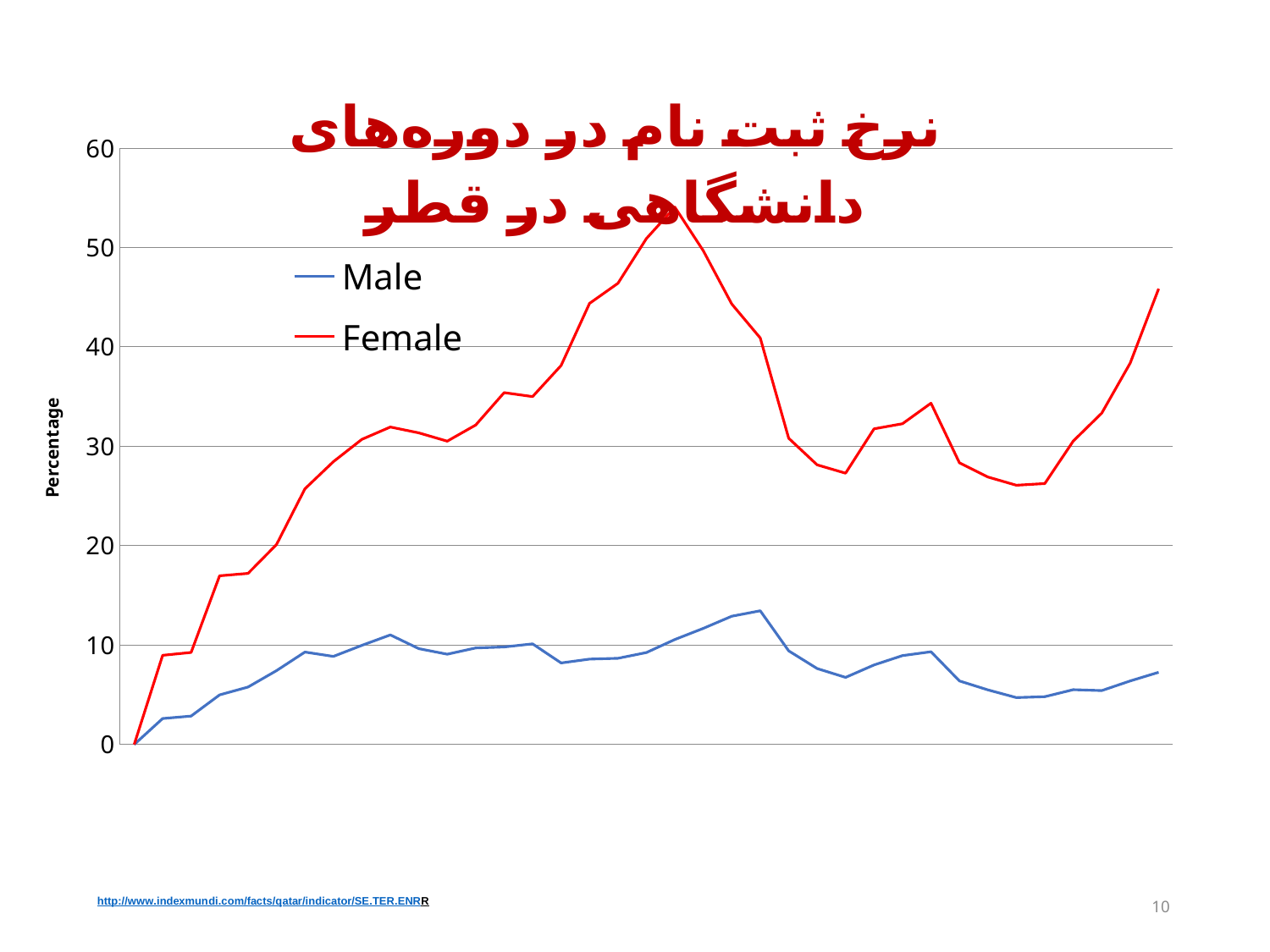
Is the last value of the Male series greater or less than 10? less What are the two series named in the legend? Male and Female What kind of chart is shown on the slide? line chart Which series reaches a higher peak, Male or Female? Female Which series is higher at the right end of the chart, Male or Female? Female Does the Female series rise or fall over its last few points? rise What is the label on the vertical axis? Percentage Is the highest value of the Female series greater or less than 50? greater How many series does the legend list? 2 Does the Male series rise or fall from its first point to its last point? rise Is the last value of the Female series greater or less than 40? greater